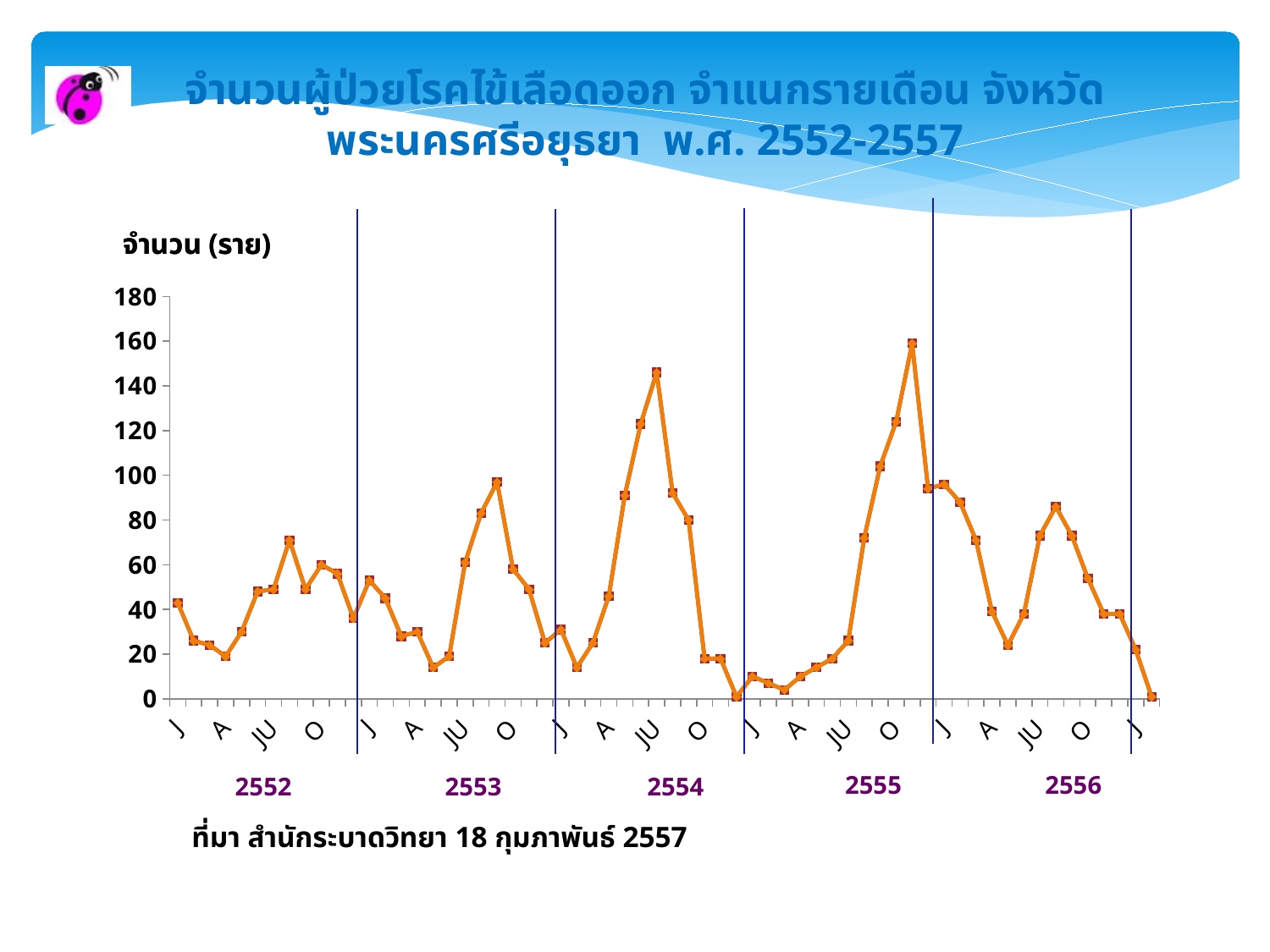
Is the peak in 2553 higher or lower than the peak in 2552? higher Which year shows the highest peak in the number of cases? 2555 What is the label on the y axis? จำนวน (ราย) In 2554, do the values rise or fall from January to July? rise Is the highest value in 2554 greater or less than 120? greater Is the lowest value at the start of 2555 greater or less than 20? less Is the highest value in 2555 greater or less than 140? greater What kind of chart is shown on the slide? line chart How many year labels are shown below the x axis? 5